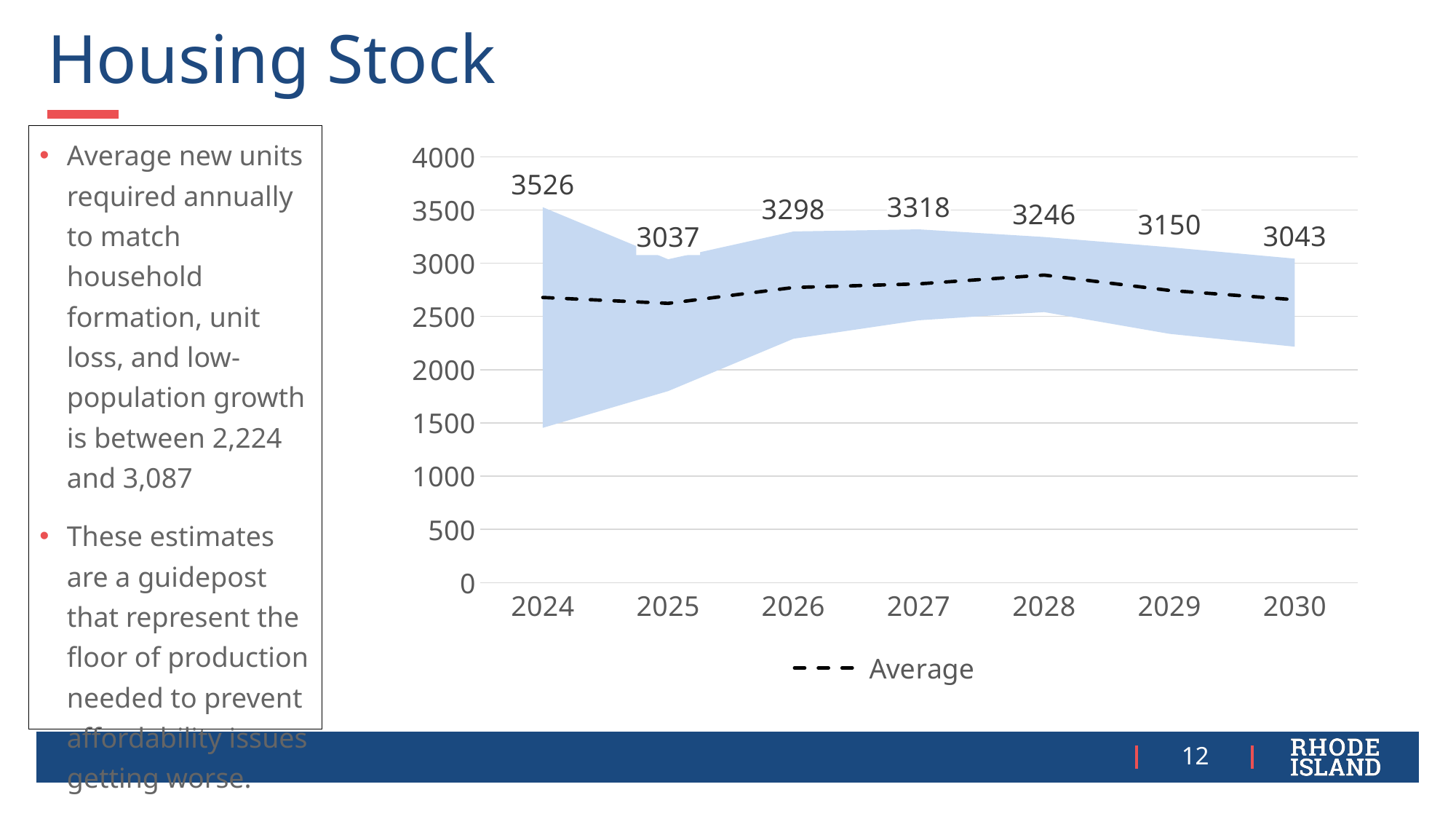
How many series does the legend list? 1 Which year has the larger labeled value, 2026 or 2027? 2027 Which year has the highest labeled value? 2024 How many years are shown on the x axis? 7 Is the Average line value for 2028 greater or less than 3000? less Do the labeled values rise or fall from 2027 to 2030? fall What data label is shown for 2027? 3318 What data label is shown for 2030? 3043 Which year has the lowest labeled value? 2025 What data label is shown for 2024? 3526 Is the Average line value for 2024 greater or less than 2500? greater What is the difference between the labeled values for 2024 and 2025? 489